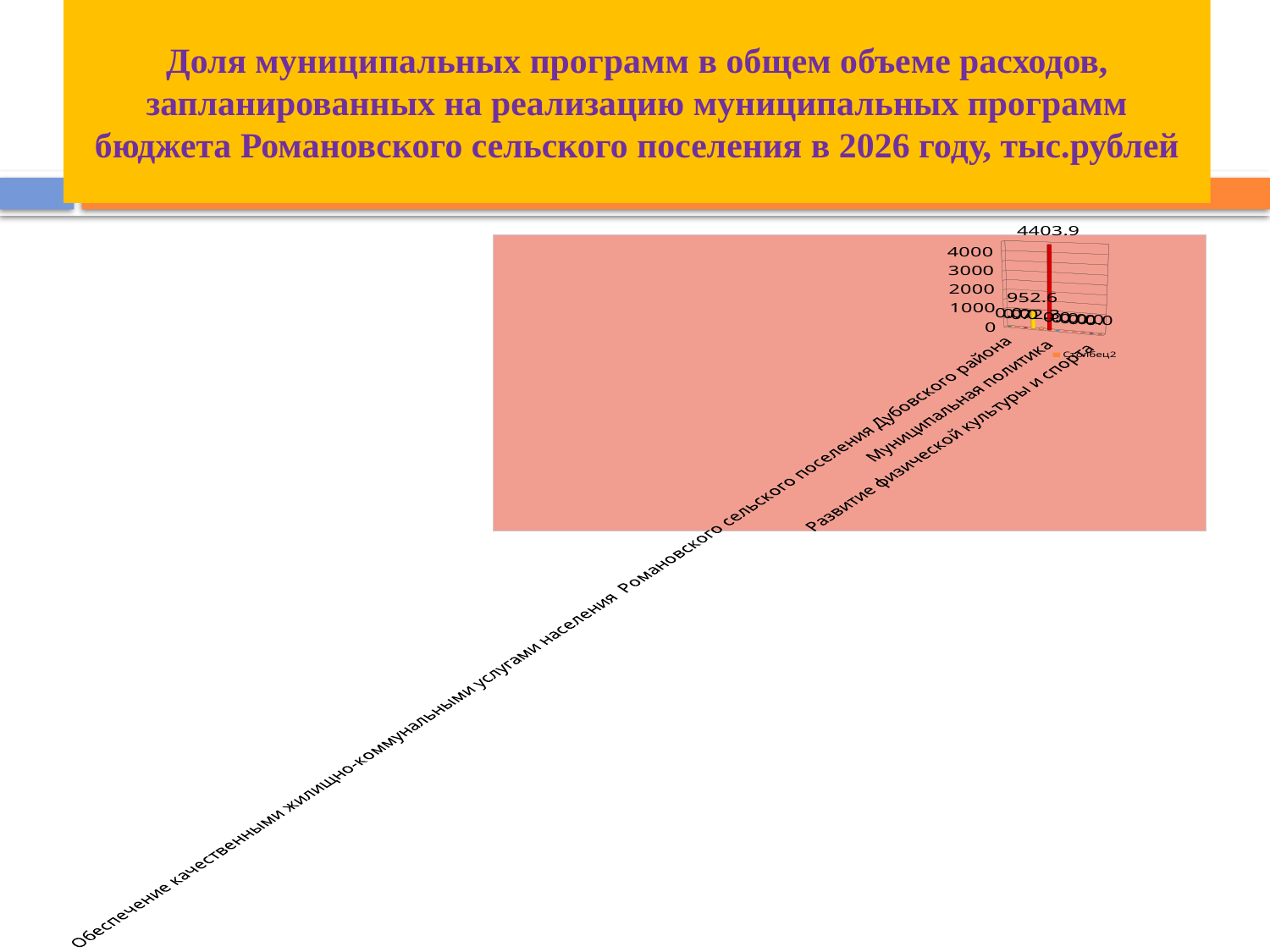
What is the difference between the values for Муниципальная политика and Обеспечение качественными жилищно-коммунальными услугами населения Романовского сельского поселения Дубовского района? 4403.9 What kind of chart is shown on the slide? bar chart Which is larger: the value for Муниципальная политика or the value for Обеспечение качественными жилищно-коммунальными услугами населения Романовского сельского поселения Дубовского района? Муниципальная политика What value is shown for Обеспечение качественными жилищно-коммунальными услугами населения Романовского сельского поселения Дубовского района? 0 Is the value for Муниципальная политика greater or less than 4000? greater Which category has the highest value in the chart? Муниципальная политика In what units are the values in the chart expressed, according to the slide title? тыс.рублей What value is shown for Муниципальная политика? 4403.9 How many series does the legend list? 1 What is the highest tick value shown on the vertical axis? 4000 Is the value for Обеспечение качественными жилищно-коммунальными услугами населения Романовского сельского поселения Дубовского района greater or less than 1000? less